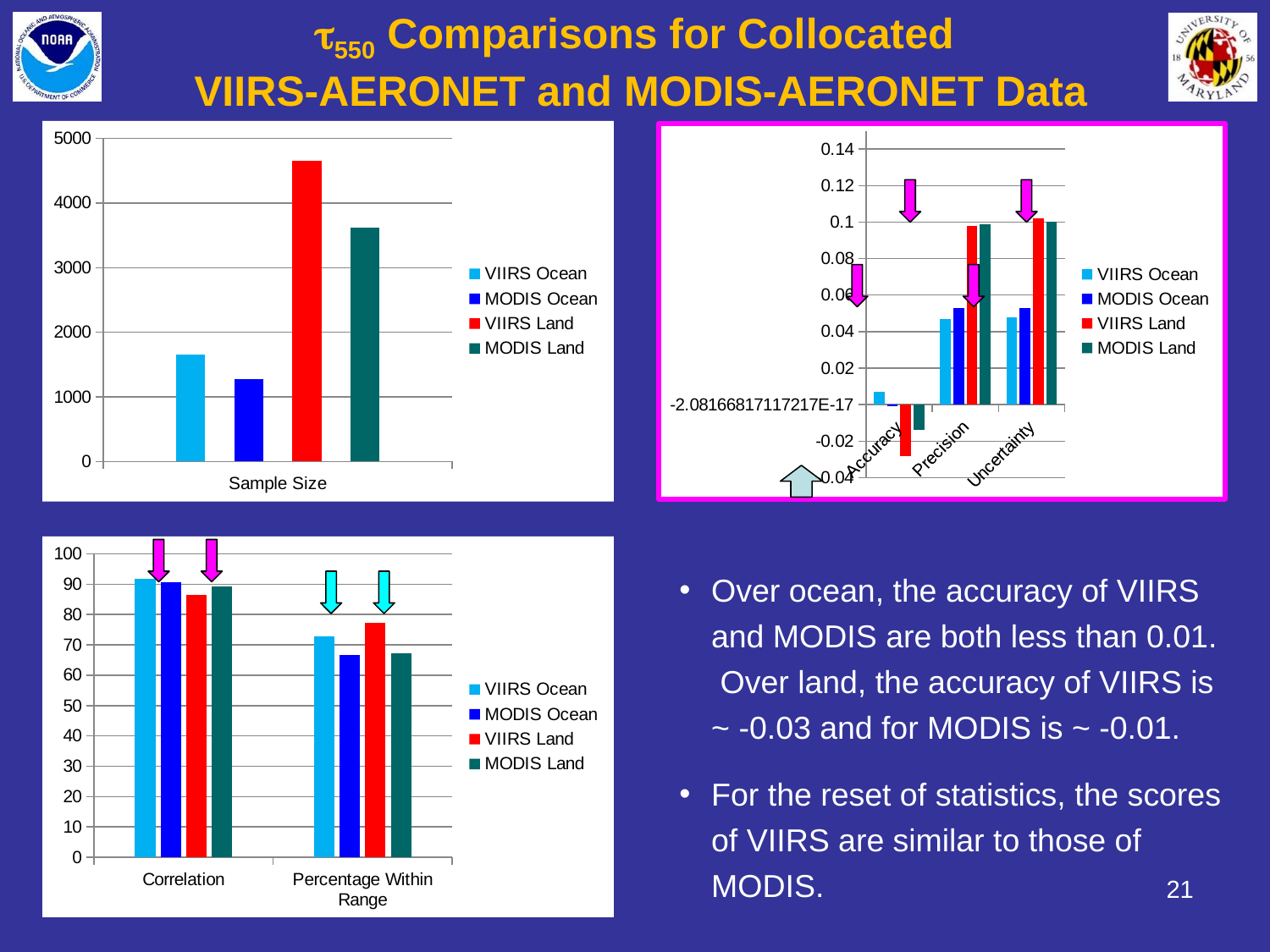
In the bottom-left chart, which is larger for Percentage Within Range, VIIRS Land or MODIS Land? VIIRS Land In the Sample Size chart (top left), which is larger, the sample size for VIIRS Ocean or for MODIS Ocean? VIIRS Ocean In the Sample Size chart (top left), which series has the largest sample size? VIIRS Land In the top-right chart, is the Precision value for VIIRS Land greater or less than 0.08? greater How many categories are shown on the x axis of the top-right chart? 3 In the Sample Size chart (top left), is the value for MODIS Ocean greater or less than 2000? less In the Sample Size chart (top left), is the value for VIIRS Land greater or less than 4000? greater In the Sample Size chart (top left), which series has the smallest sample size? MODIS Ocean What kind of chart is the top-right chart showing Accuracy, Precision and Uncertainty? bar chart How many series does the legend of the Sample Size chart (top left) list? 4